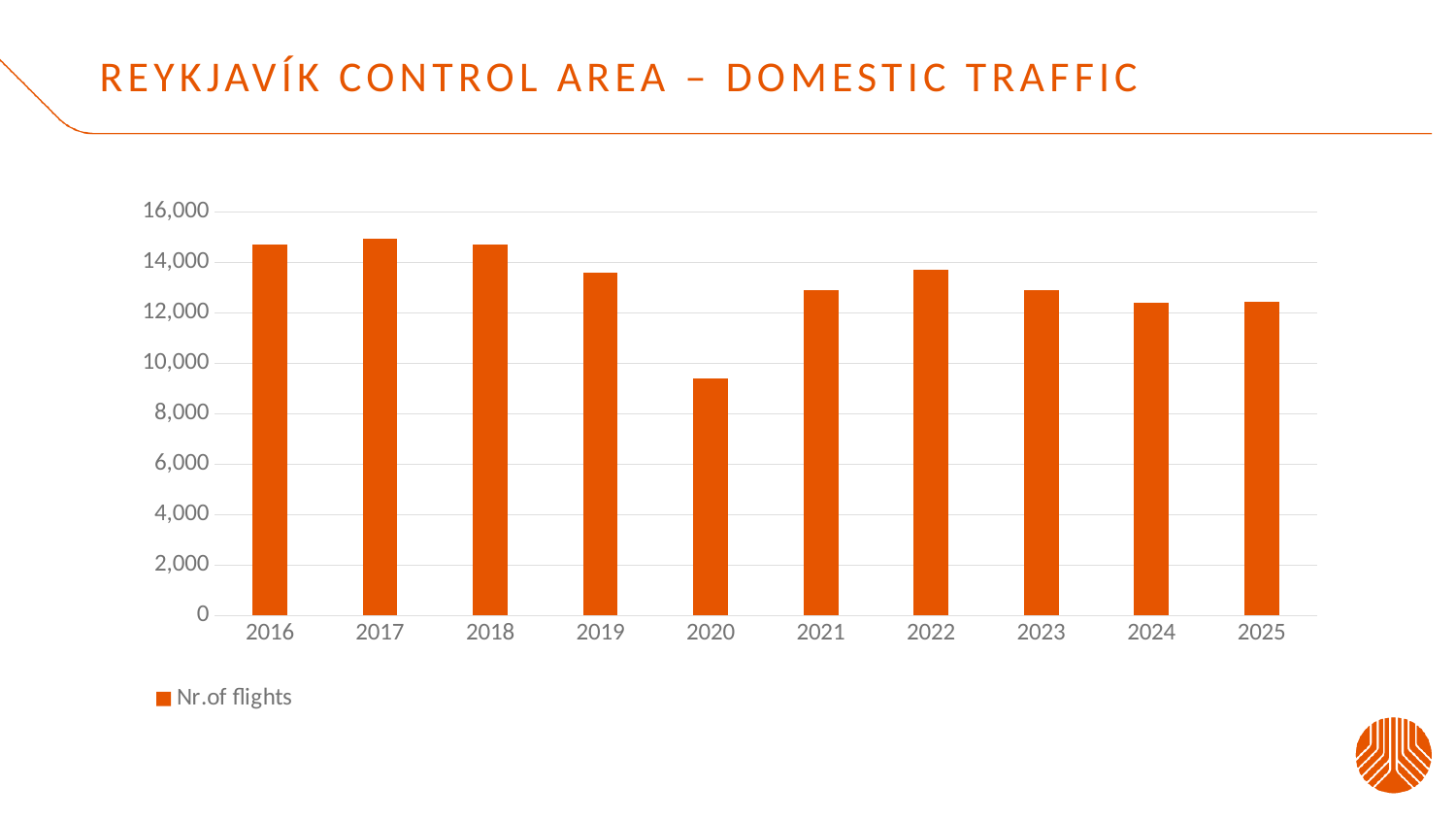
What is the series name shown in the legend? Nr.of flights Is the value for 2020 greater or less than 10,000? less Which year has the lowest number of flights? 2020 What kind of chart is shown on the slide? Bar chart Is the value for 2017 greater or less than 14,000? greater Is the value for 2024 greater or less than 12,000? greater Which year has more flights, 2016 or 2024? 2016 Do the values rise or fall from 2018 to 2020? fall How many years are shown on the x axis of the chart? 10 Which year has more flights, 2019 or 2020? 2019 How many series does the legend list? 1